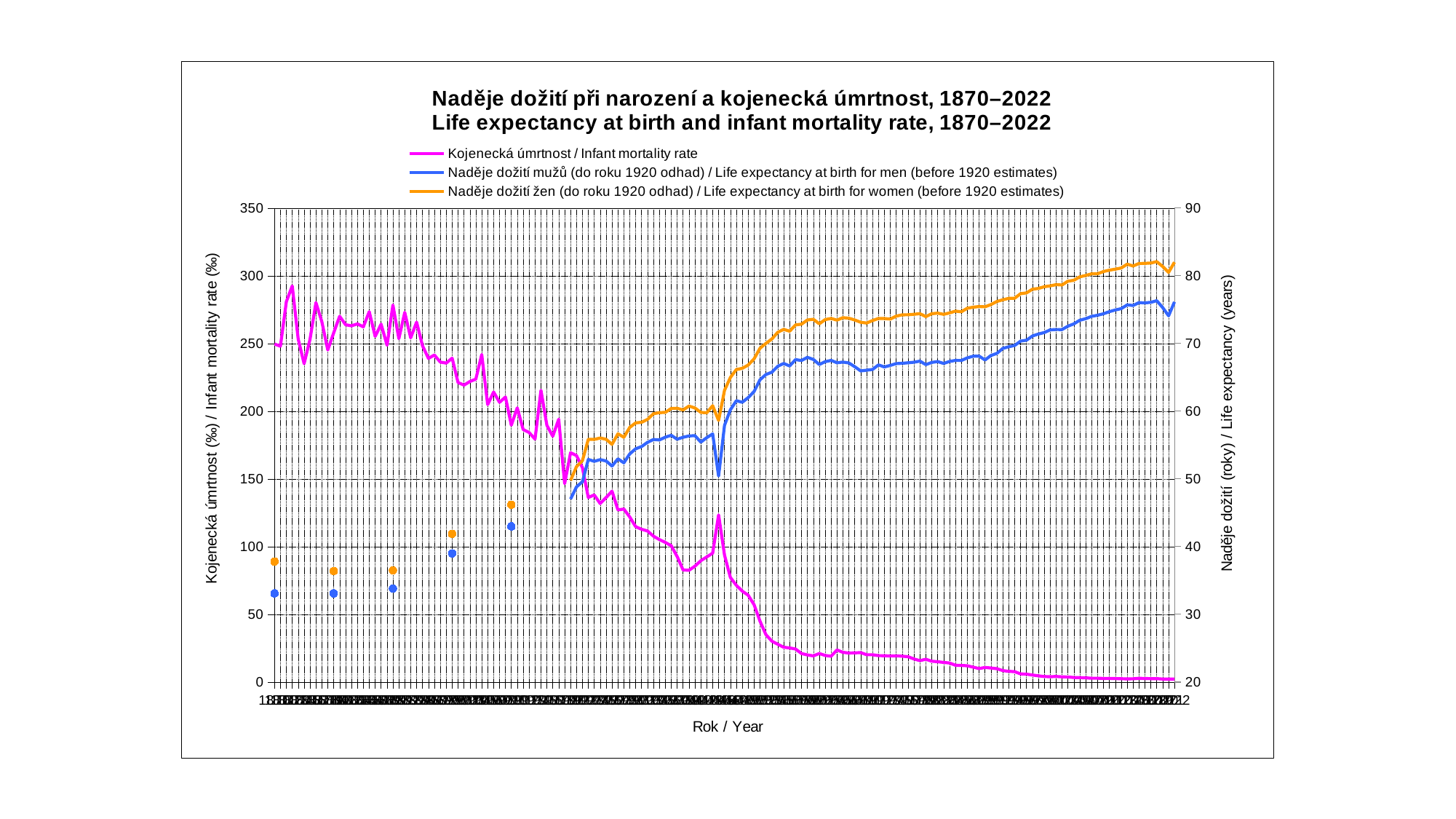
What kind of chart is shown on the slide? line chart How many series does the legend list? 3 At the right end of the chart (2022), is the infant mortality rate greater or less than 50? less At the left end of the chart (1870), is the infant mortality rate greater or less than 200? greater What is the label of the x axis? Rok / Year Does life expectancy at birth for men rise or fall overall across the period shown? rise At the right end of the chart (2022), is life expectancy at birth for men greater or less than 70? greater At the right end of the chart (2022), which is higher: life expectancy at birth for men or for women? women Does the infant mortality rate rise or fall overall from 1870 to 2022? fall What is the English title of the chart? Life expectancy at birth and infant mortality rate, 1870–2022 Does life expectancy at birth for women rise or fall overall across the period shown? rise